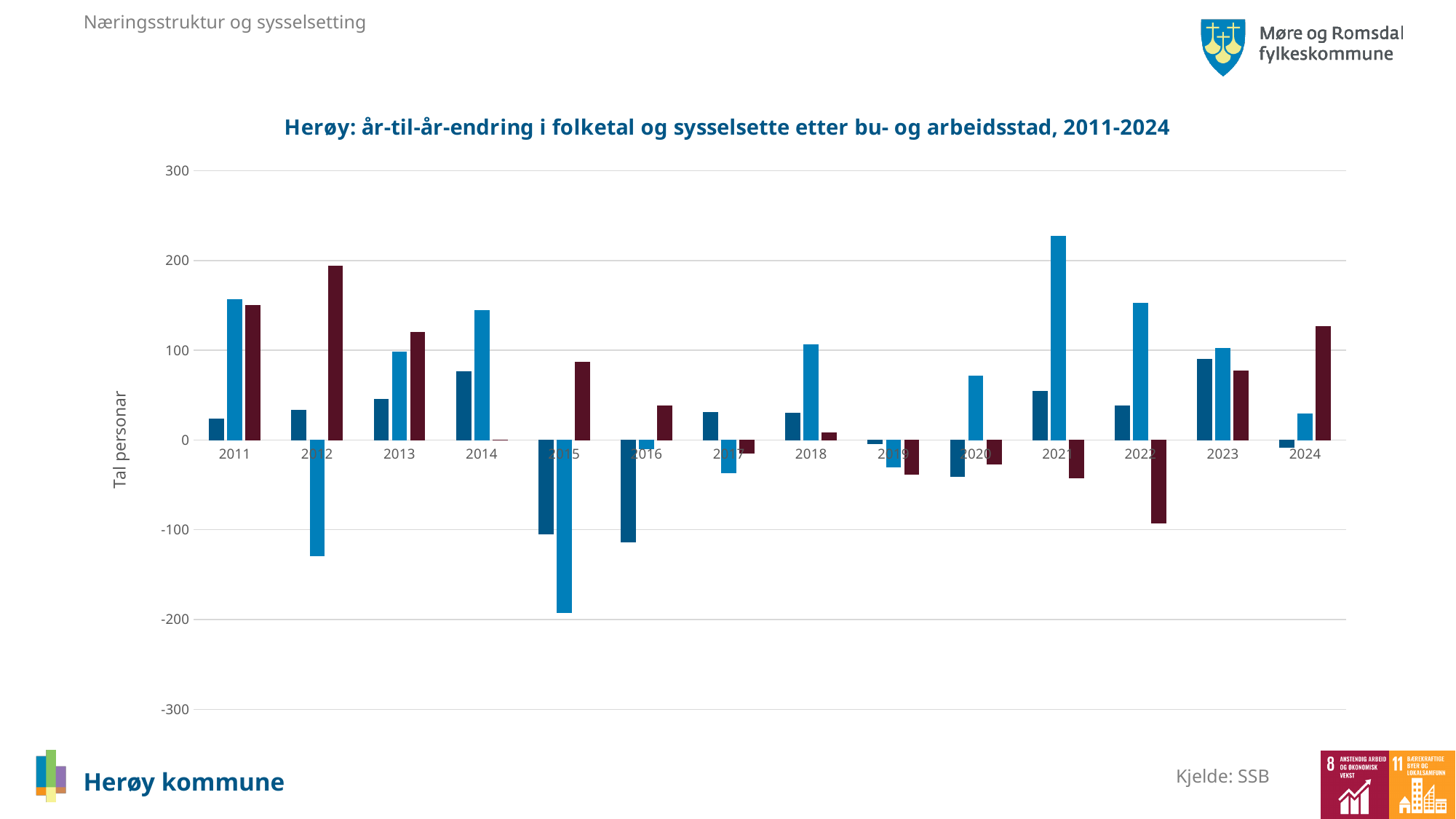
Is the value of the dark red bar for 2024 greater or less than 100? greater In which year is the dark red bar highest? 2012 Is the value of the dark blue bar for 2016 greater or less than -100? less Is the value of the light blue bar for 2021 greater or less than 200? greater What kind of chart is shown on the slide? bar chart In which year is the light blue bar lowest? 2015 How many years are shown on the x axis of the chart? 14 How many bars are plotted for each year in the chart? 3 In which year is the light blue bar highest? 2021 What is the label on the y axis of the chart? Tal personar